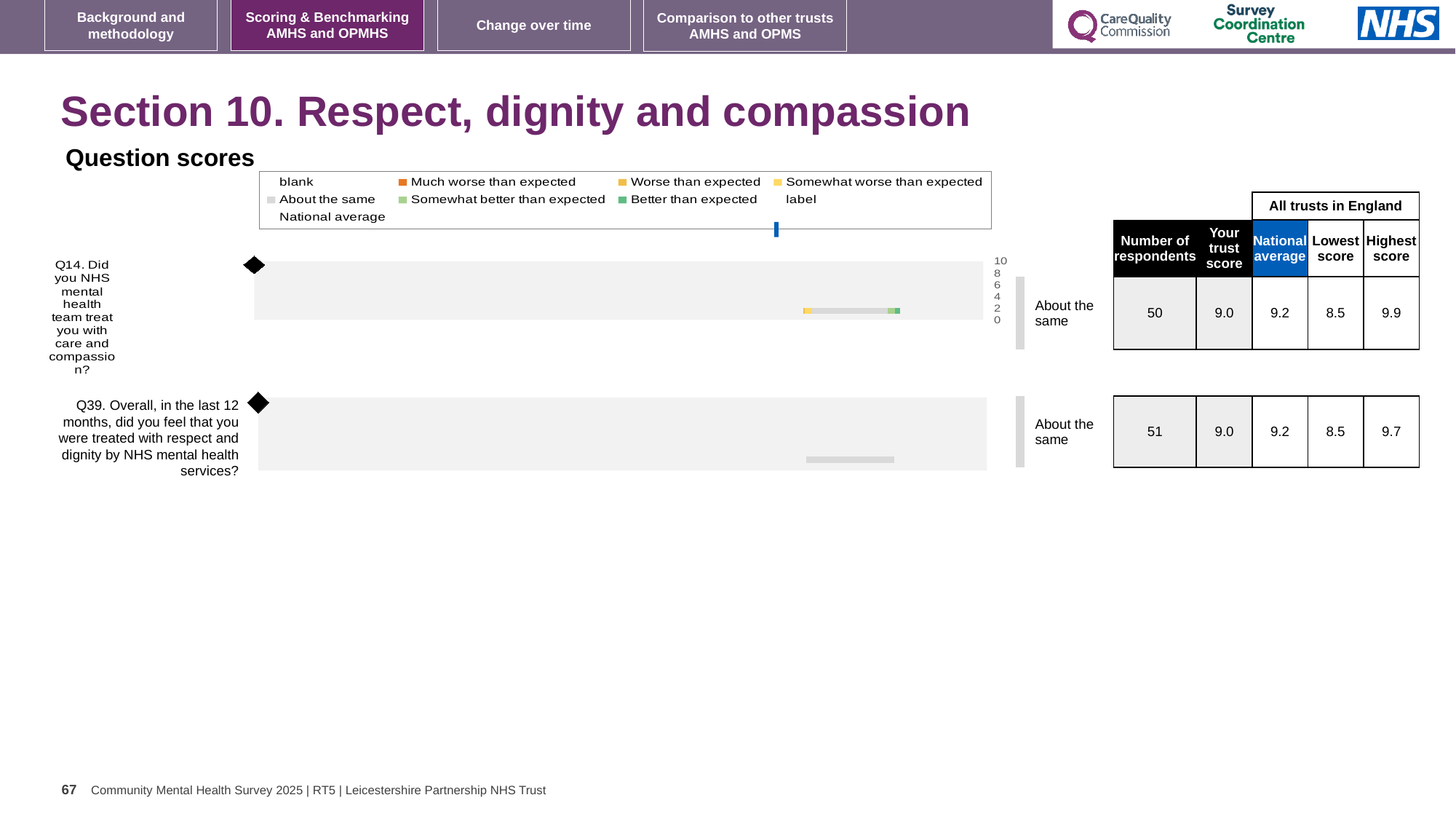
What is the highest score among all trusts in England for Q39? 9.7 What is the national average for Q14? 9.2 Which question has the higher 'Highest score' across all trusts, Q14 or Q39? Q14 What is the number of respondents for Q39 (respect and dignity)? 51 What kind of chart is used to show the question scores? bar chart What benchmark category is shown for Q14? About the same How many questions are plotted in the question scores chart? 2 What is the lowest score among all trusts in England for Q14? 8.5 What is the difference between the highest score and the lowest score for Q14? 1.4 What is the difference between the national average and the trust score for Q39? 0.2 What is the 'Your trust score' for Q14 (care and compassion)? 9.0 What is the maximum value shown on the chart's score axis? 10